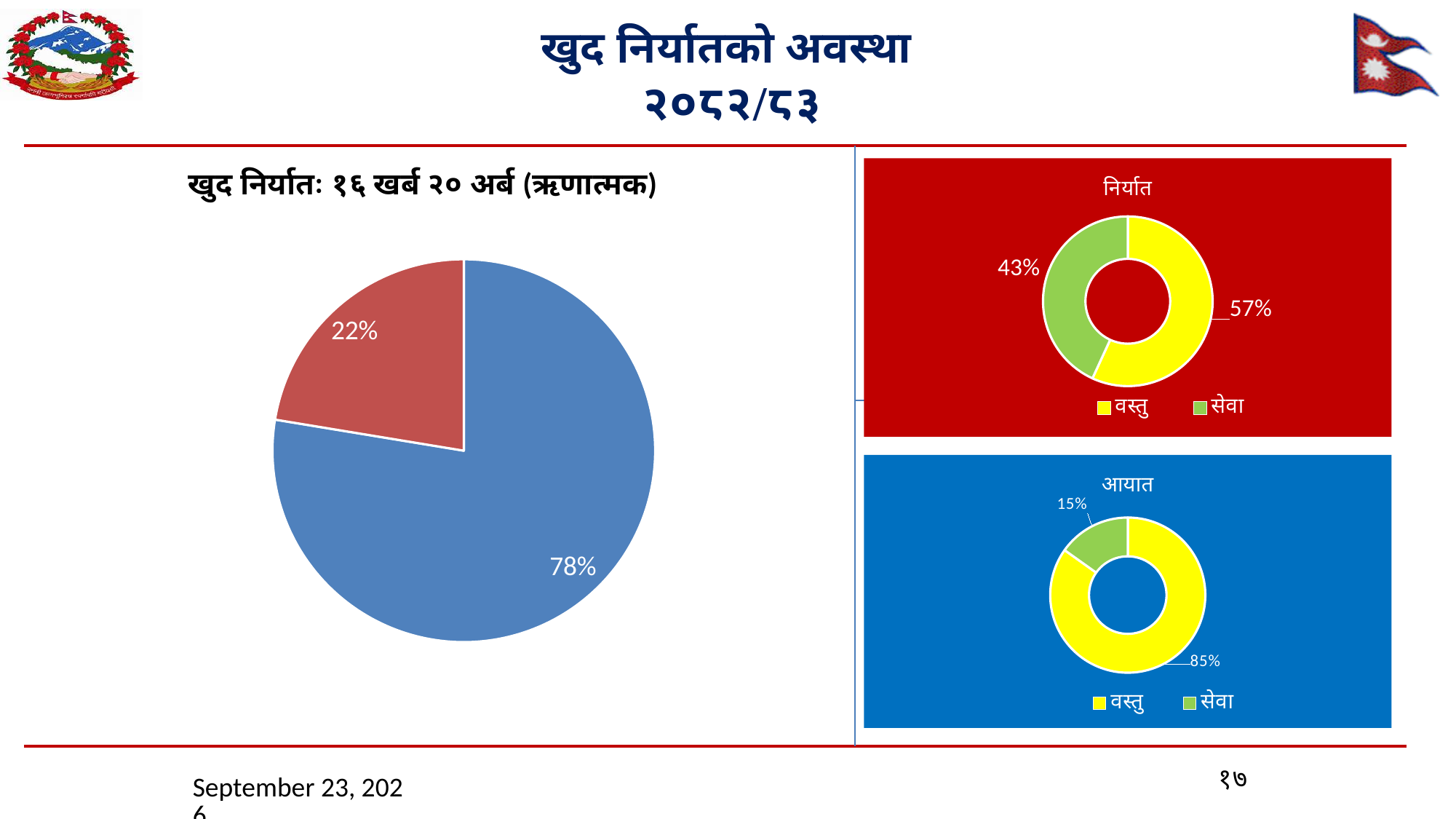
In the आयात doughnut chart, what share does वस्तु have? 85% How many categories does the legend of the निर्यात doughnut chart list? 2 Is the share of वस्तु larger in the निर्यात chart or in the आयात chart? आयात What kind of chart is the large chart on the left side of the slide? Pie chart In the आयात doughnut chart, what is the difference in percentage points between वस्तु and सेवा? 70 In the निर्यात doughnut chart, which category has the smallest share? सेवा In the pie chart on the left side of the slide, what is the value of the largest slice? 78% In the निर्यात doughnut chart, what share does वस्तु have? 57% In the pie chart on the left side of the slide, how many slices are there? 2 In the आयात doughnut chart, what share does सेवा have? 15% In the निर्यात doughnut chart, what share does सेवा have? 43% In the आयात doughnut chart, which category has the largest share? वस्तु